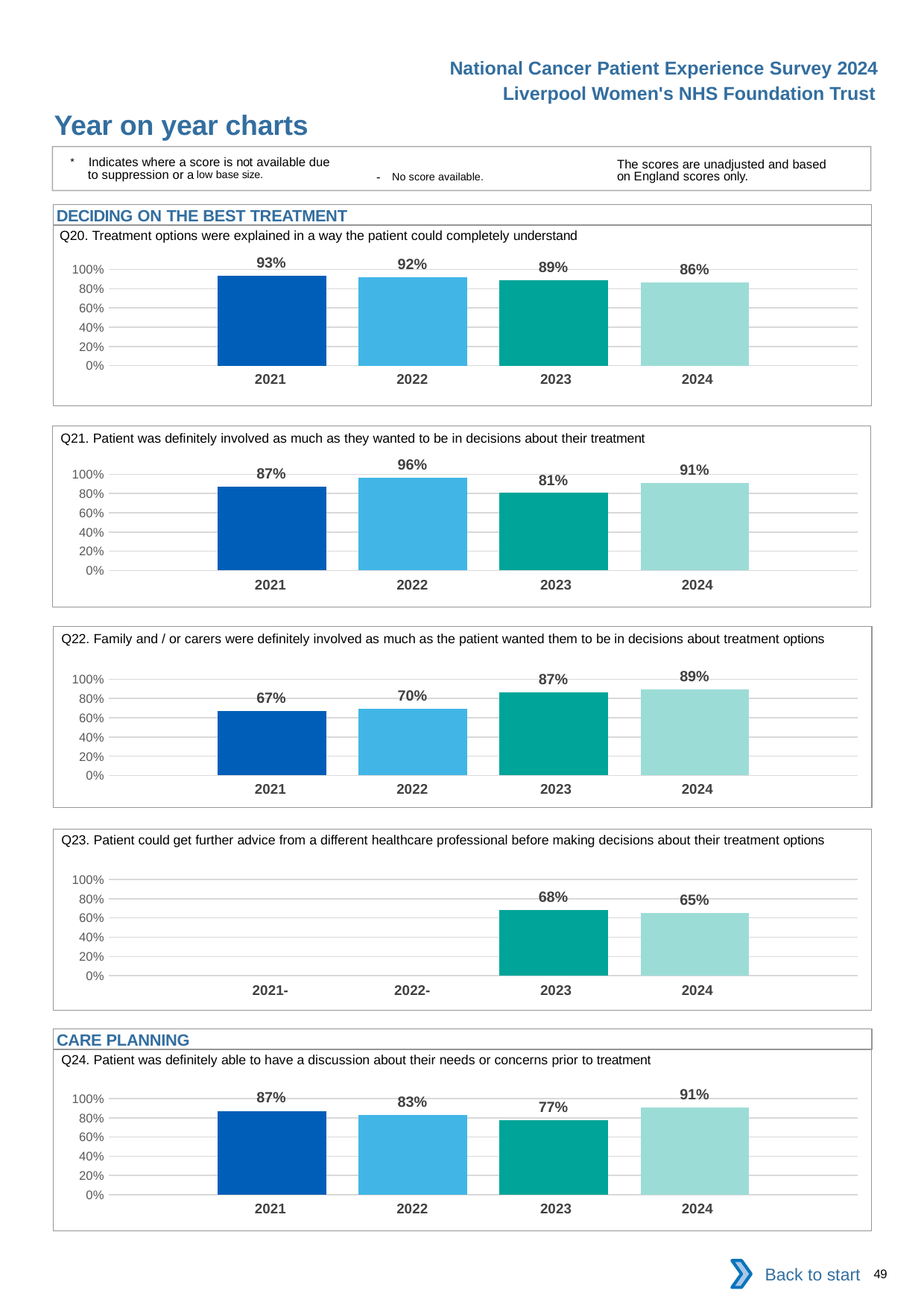
In the Q21 chart, which year has the lowest value? 2023 In the Q24 chart, what is the value for 2023? 77% In the Q23 chart, how many years have a bar plotted? 2 In the Q21 chart, which year has the highest value? 2022 What kind of chart is the Q24 chart? bar chart In the Q21 chart, what is the difference between the 2022 and 2023 values? 15 percentage points In the Q23 chart, which is larger, the 2023 value or the 2024 value? 2023 In the Q22 chart, what is the value for 2024? 89% In the Q20 chart, do the values rise or fall from 2021 to 2024? fall In the Q20 chart, what is the value for 2021? 93% In the Q24 chart, what is the difference between the 2024 and 2021 values? 4 percentage points In the Q22 chart, do the values rise or fall from 2021 to 2024? rise